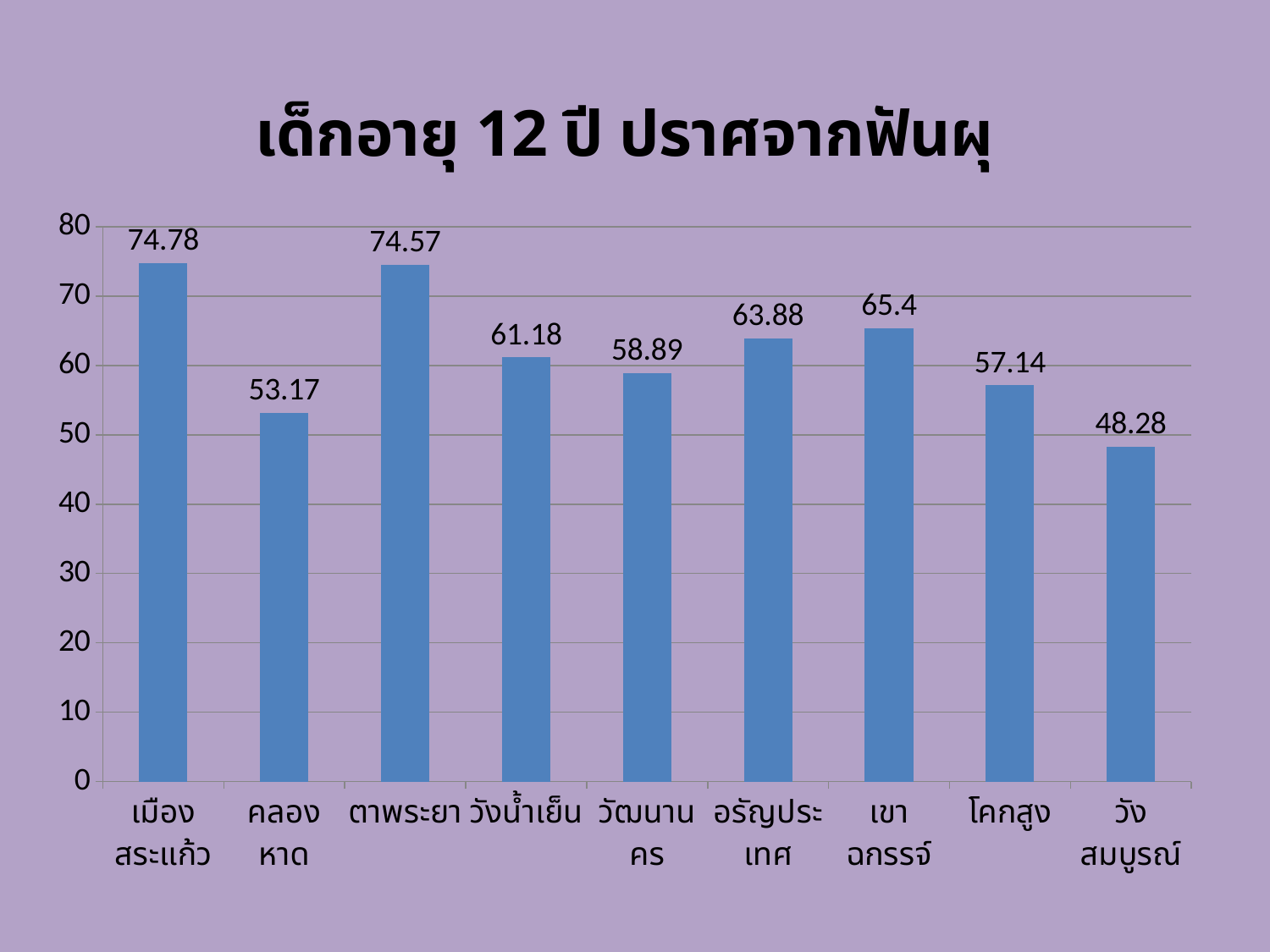
Which category has the highest value? เมืองสระแก้ว What is the value for เมืองสระแก้ว? 74.78 What type of chart is shown on the slide? bar chart What is the difference between the values for ตาพระยา and วังน้ำเย็น? 13.39 How many categories (districts) are shown on the x axis? 9 What is the value for วังสมบูรณ์? 48.28 Which is larger, the value for อรัญประเทศ or the value for วัฒนานคร? อรัญประเทศ What is the value for เขาฉกรรจ์? 65.4 What is the title of the chart? เด็กอายุ 12 ปี ปราศจากฟันผุ Is the value for โคกสูง greater or less than 60? less What is the value for คลองหาด? 53.17 Which category has the lowest value? วังสมบูรณ์